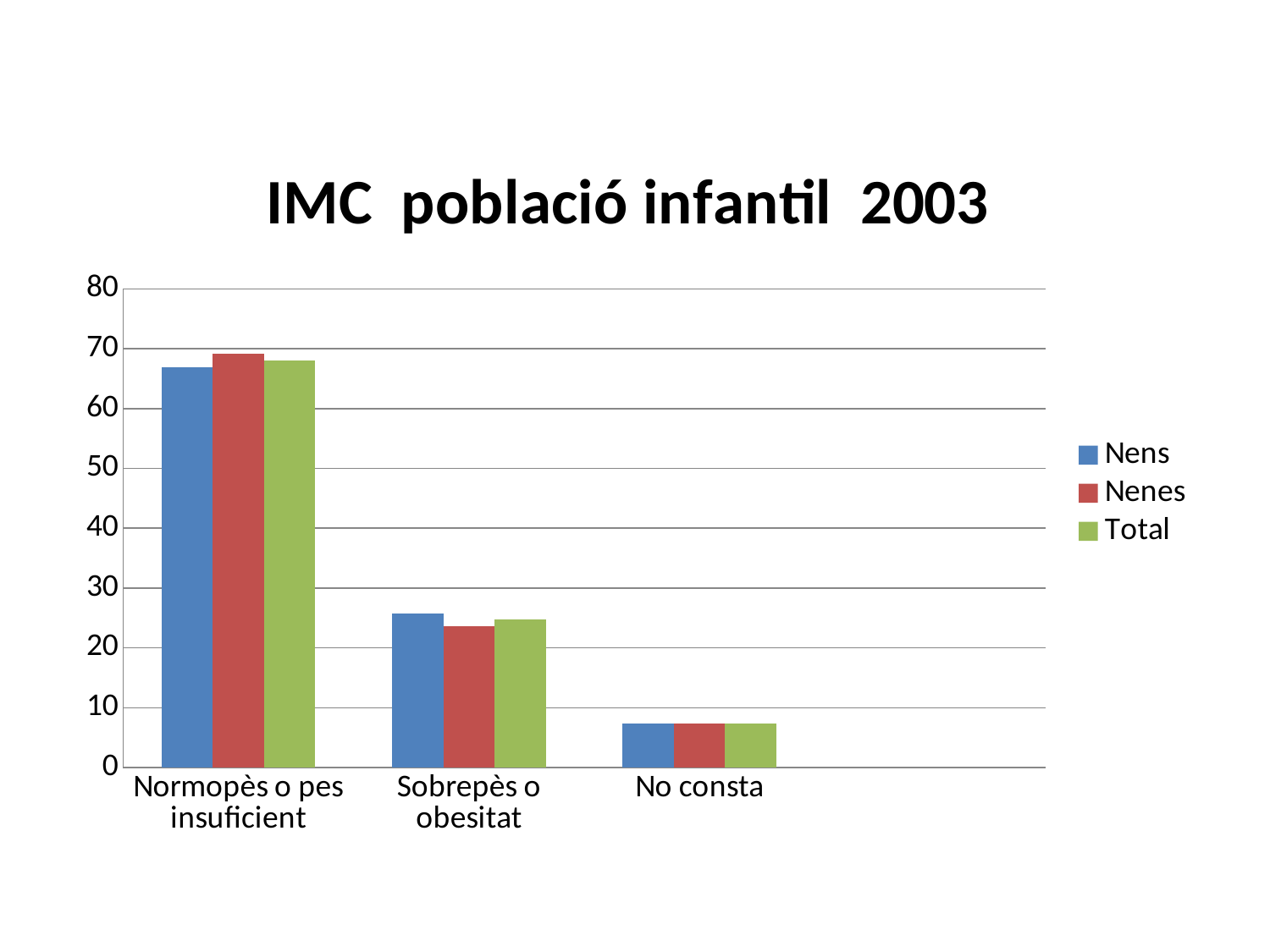
Which series is shown in red in the legend? Nenes What kind of chart is shown on the slide? bar chart How many categories are shown on the x axis? 3 Which category has the lowest value for the Nens series? No consta Is the value for Total in the 'No consta' category greater or less than 10? less How many series does the legend list? 3 In the 'Sobrepès o obesitat' category, which is larger, Nens or Nenes? Nens What is the title of the chart? IMC població infantil 2003 Which category has the highest value for the Total series? Normopès o pes insuficient Is the value for Nens in the 'Sobrepès o obesitat' category greater or less than 20? greater Is the value for Nenes in the 'Sobrepès o obesitat' category greater or less than 30? less